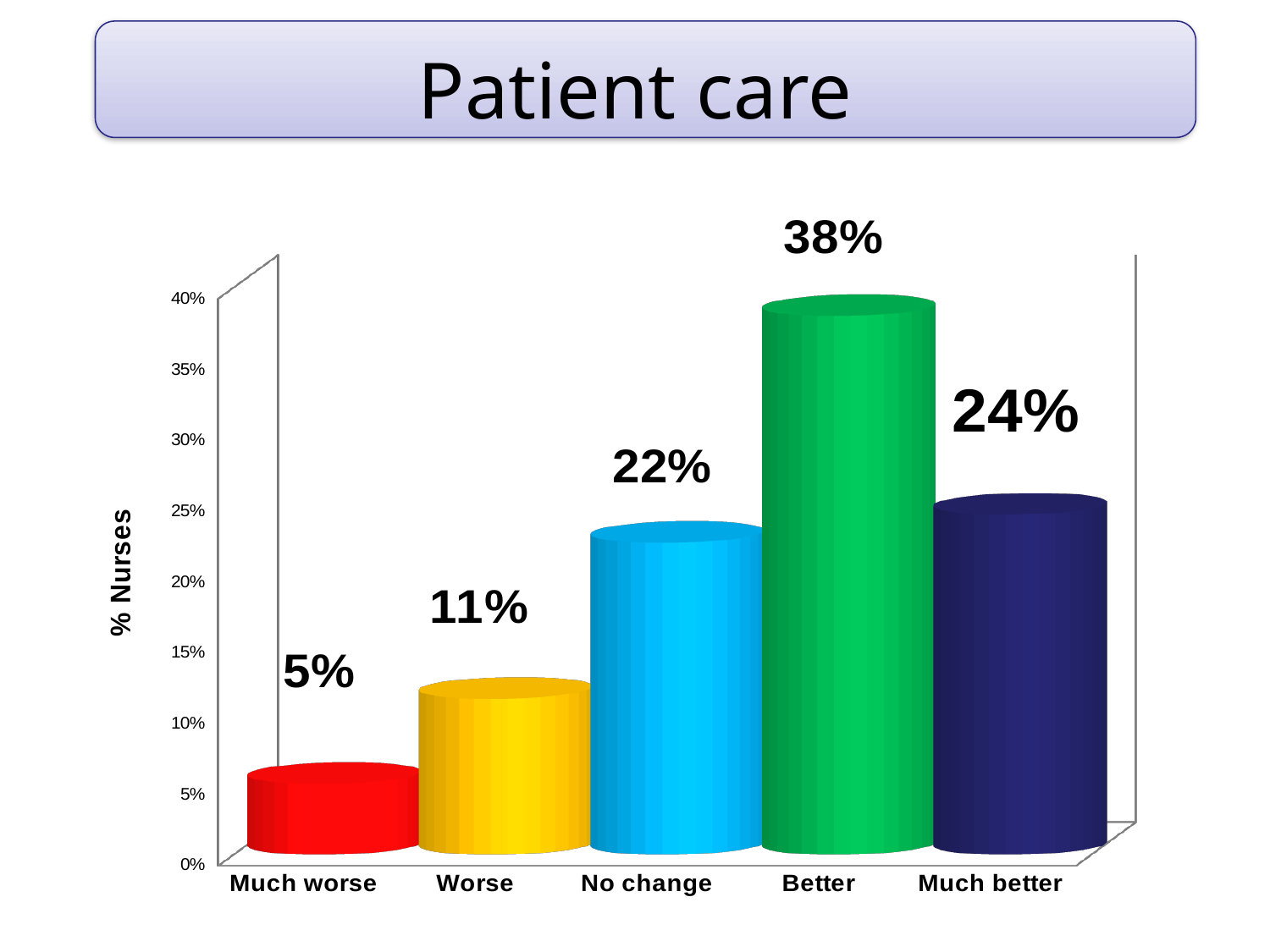
Which is larger, the value for Much better or the value for No change? Much better What kind of chart is shown on the slide? bar chart Is the value for Worse greater or less than 15%? less What is the difference between the values for No change and Worse? 11% What is the value for No change? 22% Which category has the highest value? Better What is the value for Much worse? 5% What is the label of the vertical axis? % Nurses How many categories are shown on the x axis? 5 What is the value for Better? 38% What is the difference between the values for Better and Much better? 14% Which category has the lowest value? Much worse